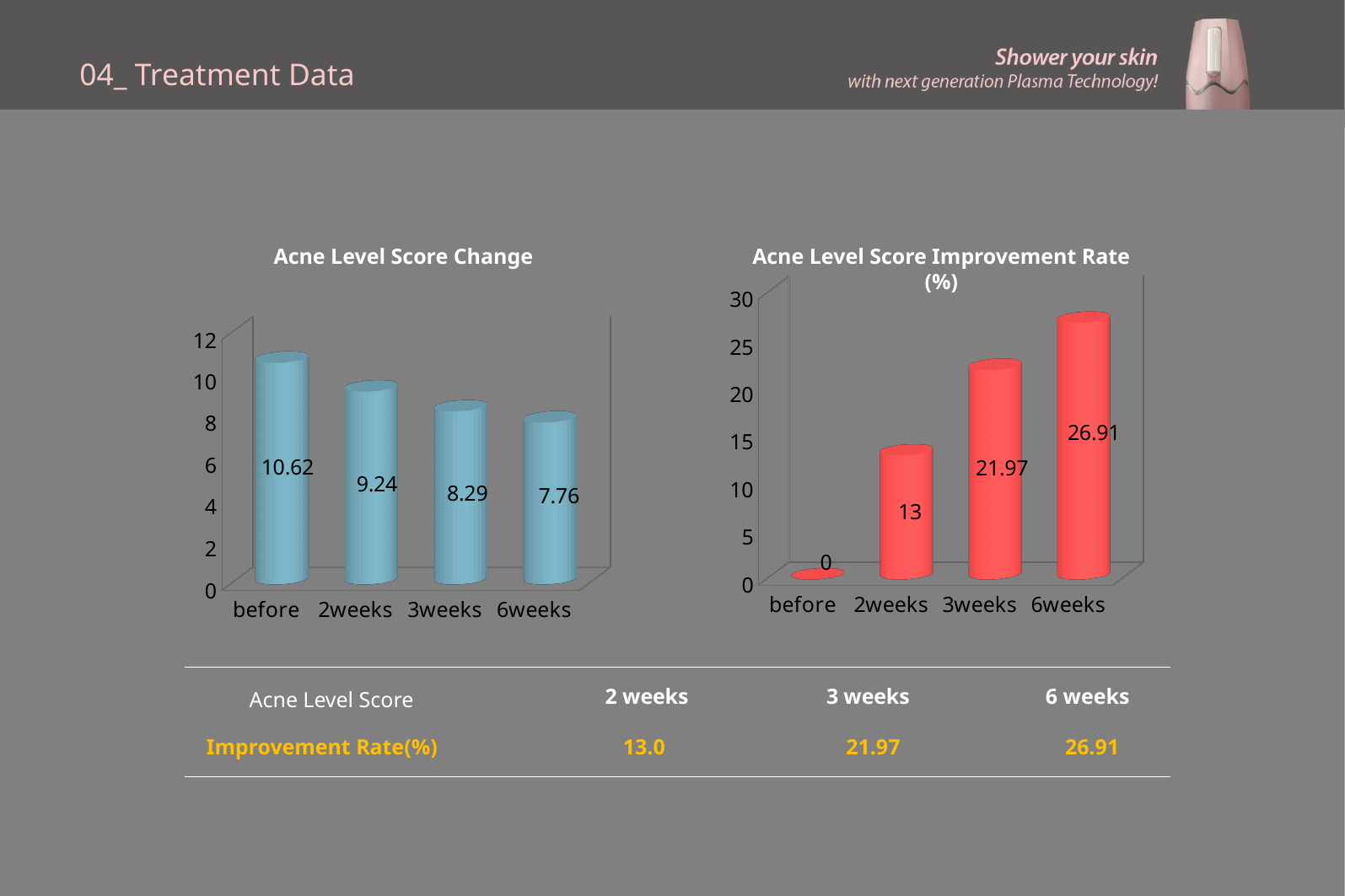
In the 'Acne Level Score Improvement Rate (%)' chart, what is the value for 2weeks? 13 In the 'Acne Level Score Improvement Rate (%)' chart, what is the value for 3weeks? 21.97 In the 'Acne Level Score Improvement Rate (%)' chart, which category has the highest value? 6weeks In the 'Acne Level Score Change' chart, what is the value for 'before'? 10.62 In the 'Acne Level Score Change' chart, which category has the lowest value? 6weeks In the 'Acne Level Score Change' chart, what is the value for 6weeks? 7.76 In the 'Acne Level Score Change' chart, what is the difference between the 'before' value and the 2weeks value? 1.38 In the 'Acne Level Score Improvement Rate (%)' chart, which is larger, the value for 2weeks or the value for 3weeks? 3weeks What kind of chart is the 'Acne Level Score Improvement Rate (%)' chart? bar chart In the 'Acne Level Score Change' chart, how many categories are shown on the x axis? 4 In the 'Acne Level Score Improvement Rate (%)' chart, what is the difference between the 6weeks value and the 3weeks value? 4.94 In the 'Acne Level Score Change' chart, do the values rise or fall from 'before' to 6weeks? fall